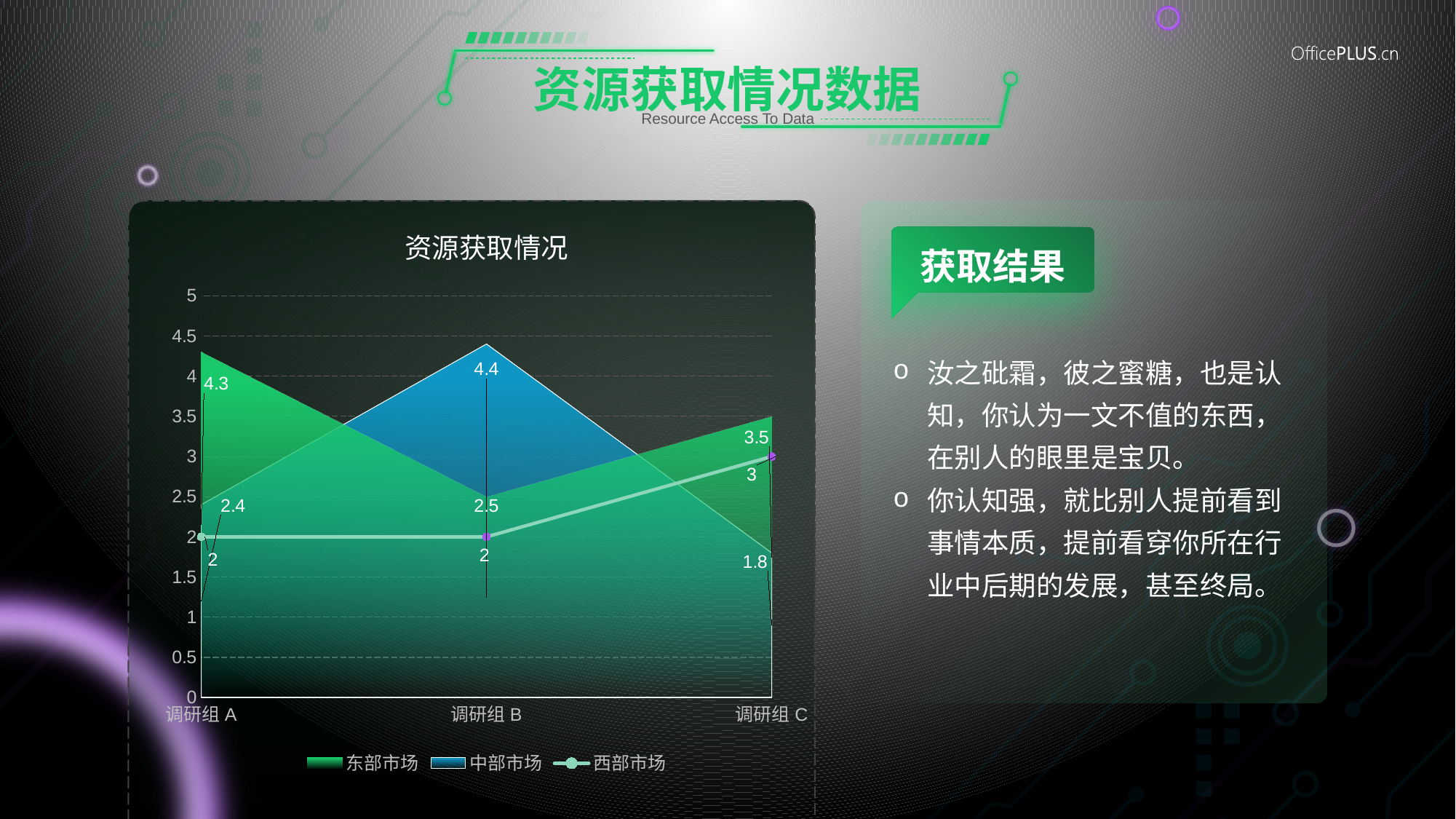
How many series does the legend list? 3 What is the difference between the 中部市场 values for 调研组 B and 调研组 C? 2.6 Which category has the highest value for 中部市场? 调研组 B What is the value of 中部市场 for 调研组 B? 4.4 Which category has the lowest value for 东部市场? 调研组 B What is the value of 东部市场 for 调研组 A? 4.3 How many categories are shown on the x axis? 3 What is the value of 中部市场 for 调研组 C? 1.8 For 调研组 C, which is larger: 东部市场 or 中部市场? 东部市场 What is the title of the chart? 资源获取情况 What is the difference between 东部市场 and 中部市场 for 调研组 A? 1.9 What is the value of 西部市场 for 调研组 C? 3